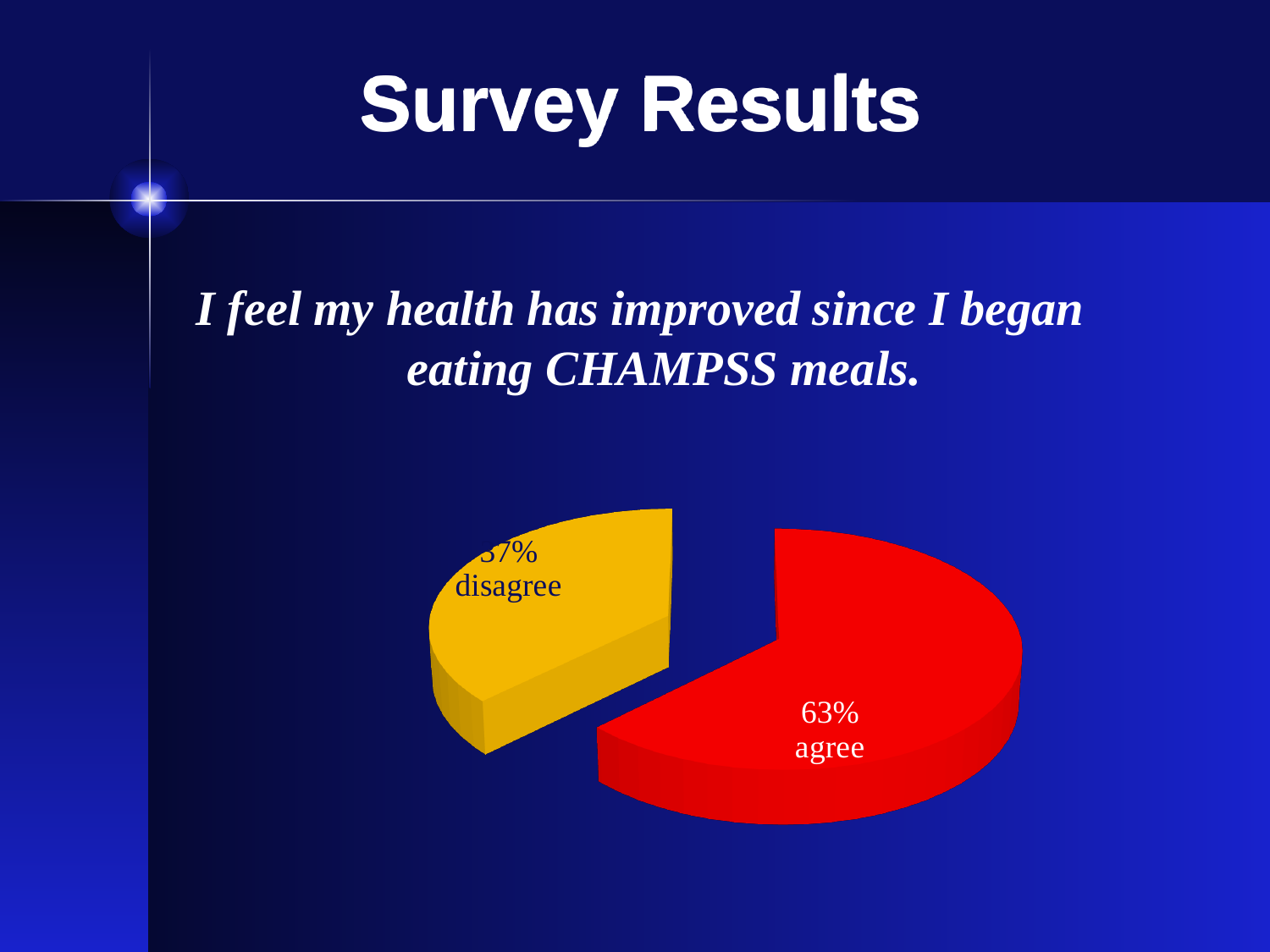
Which response has the larger share of the pie, agree or disagree? agree What colour is the 'agree' slice of the pie? red What percentage of respondents agree that their health has improved since they began eating CHAMPSS meals? 63% Which response has the smallest slice of the pie? disagree Which response has the largest slice of the pie? agree What is the difference in percentage points between the agree and disagree slices? 26 What survey statement does the pie chart report results for? I feel my health has improved since I began eating CHAMPSS meals. What kind of chart is shown on the slide? pie chart Is the share of respondents who agree greater or less than 50%? greater What percentage of respondents disagree with the statement? 37% How many slices does the pie chart have? 2